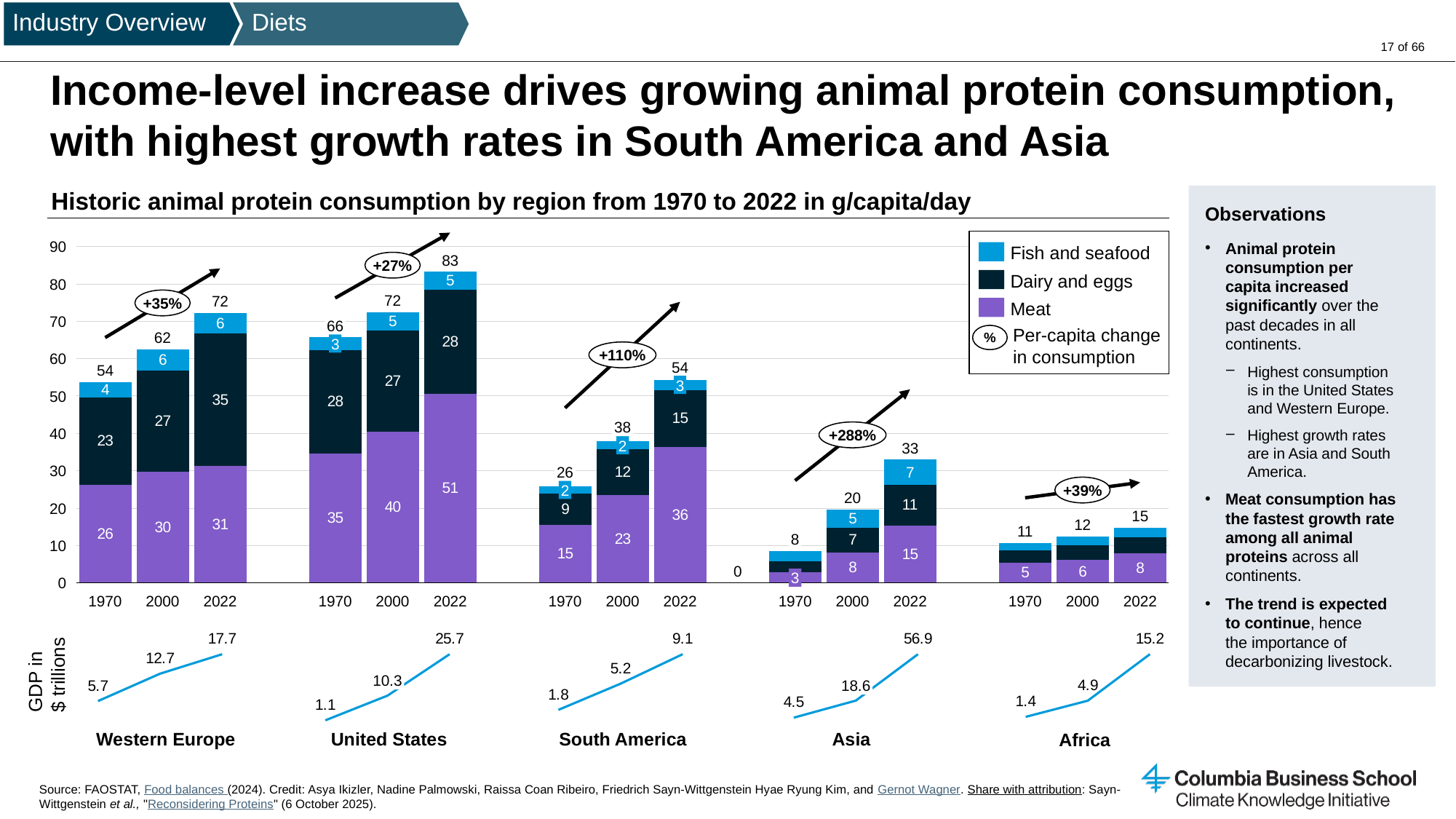
In the stacked bar chart, which region and year has the lowest total animal protein consumption? Asia, 1970 In the stacked bar chart, by how much did Western Europe's total consumption increase from 1970 to 2022? 18 In the stacked bar chart, which region and year has the highest total animal protein consumption? United States, 2022 In the stacked bar chart, what is the total animal protein consumption for the United States in 2022? 83 What per-capita change in consumption is shown for Asia? +288% In the stacked bar chart, which is larger: the 2022 total for Asia or the 2022 total for Africa? Asia How many regions are shown in the stacked bar chart? 5 In the stacked bar chart, do Western Europe's total values rise or fall from 1970 to 2022? Rise How many series does the legend of the stacked bar chart list? 3 In the GDP line charts below the bar chart, what is the GDP value for Asia in 2022? 56.9 What kind of chart is used to show animal protein consumption by region? Stacked bar chart In the stacked bar chart, what is the meat value for South America in 2022? 36